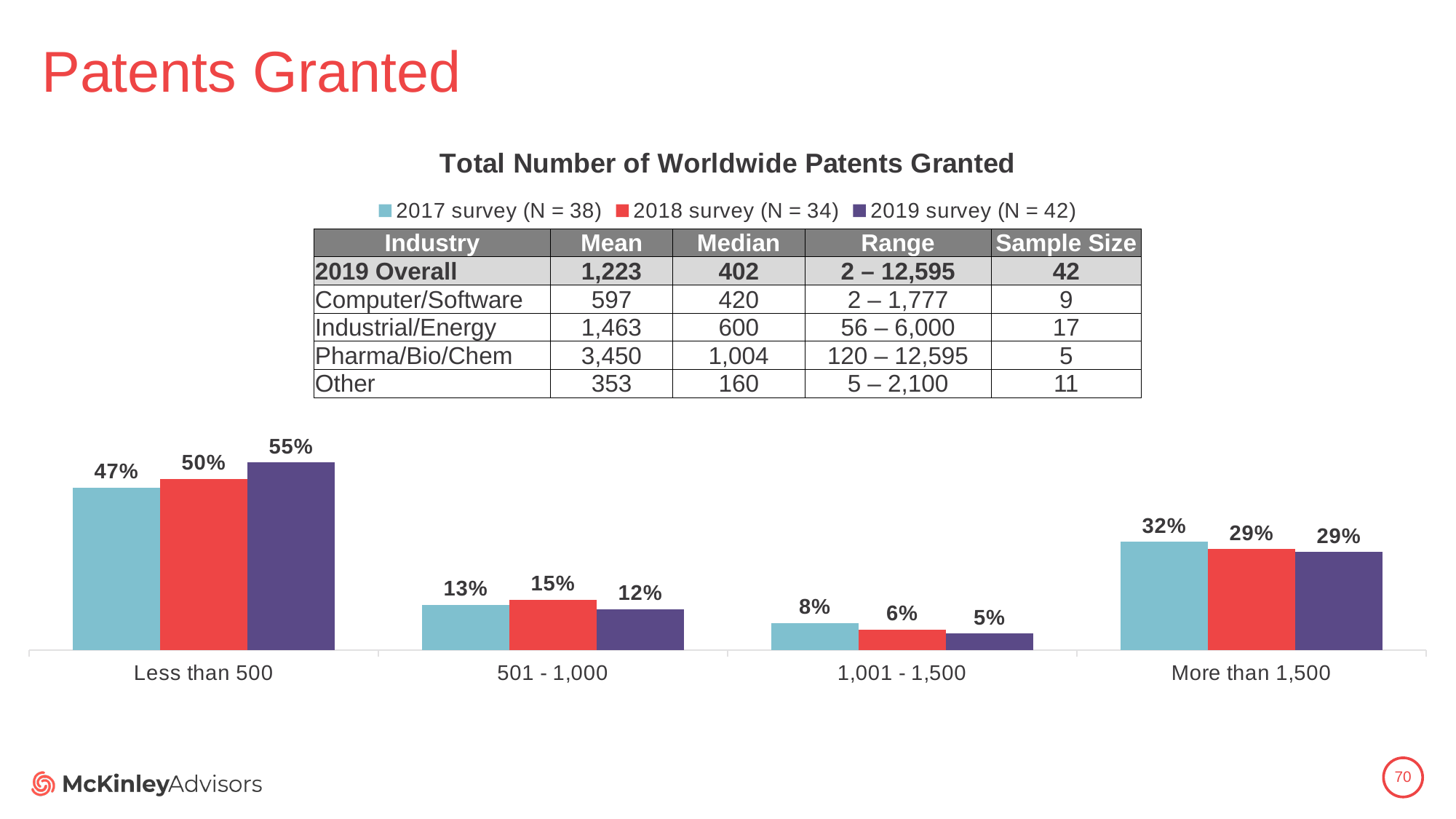
What is the sample size (N) for the 2019 survey shown in the legend? 42 What is the title of the chart? Total Number of Worldwide Patents Granted What kind of chart is shown on the slide? Bar chart Which category has the highest value for the 2019 survey? Less than 500 What is the value for the 2017 survey in the 'More than 1,500' category? 32% How many categories are shown on the x axis of the chart? 4 What is the value for the 2019 survey in the 'Less than 500' category? 55% What is the value for the 2018 survey in the '501 - 1,000' category? 15% What is the difference between the 2019 survey and 2017 survey values in the 'Less than 500' category? 8% Which is larger in the '501 - 1,000' category: the 2018 survey value or the 2019 survey value? 2018 survey How many series does the chart legend list? 3 Which category has the lowest value for the 2017 survey? 1,001 - 1,500